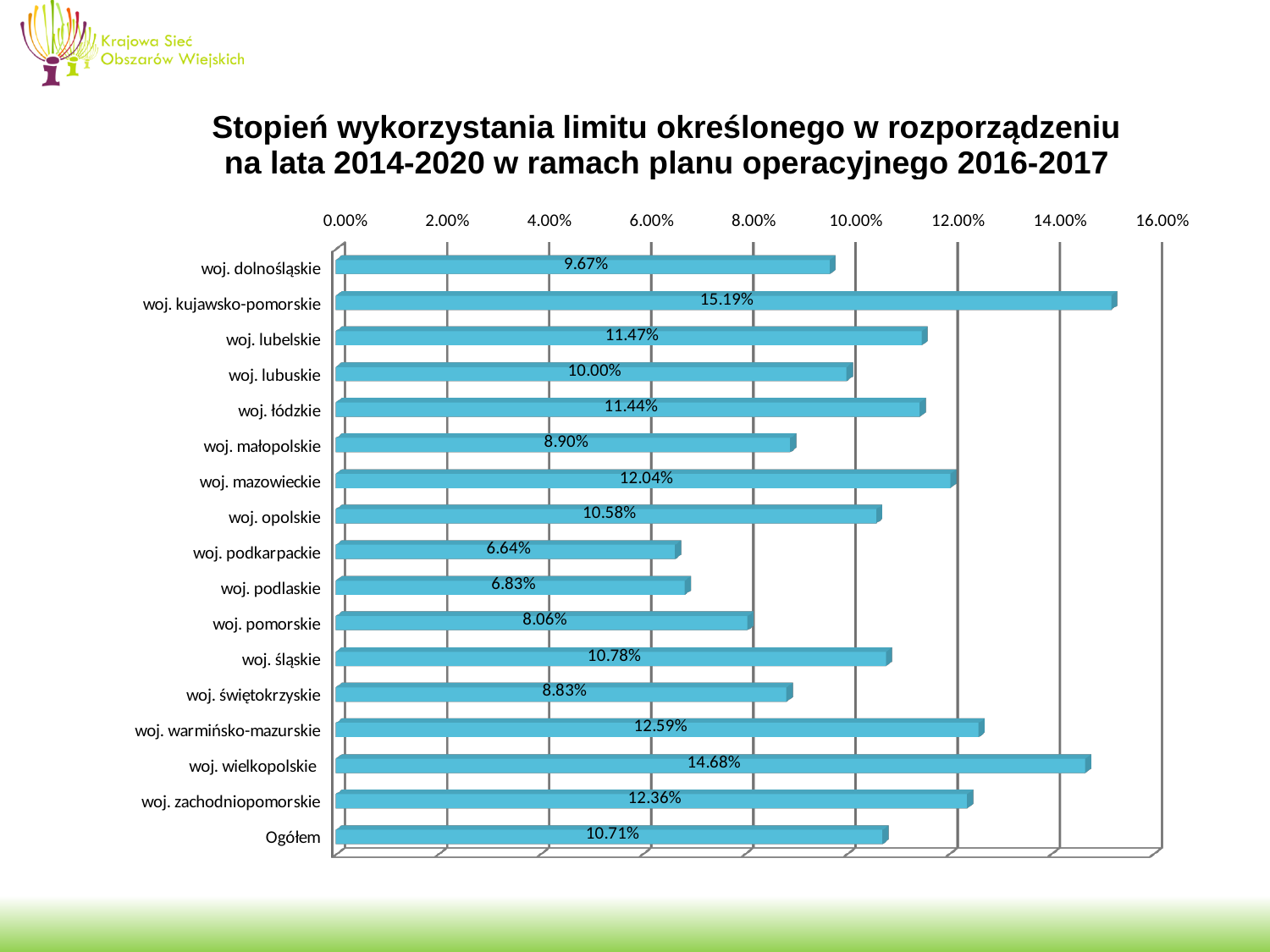
What is the maximum value shown on the horizontal axis? 16.00% What is the value for woj. podkarpackie? 6.64% What kind of chart is shown on the slide? bar chart Is the value for woj. warmińsko-mazurskie greater or less than 12.00%? greater Which category has the highest value? woj. kujawsko-pomorskie What is the value for Ogółem? 10.71% Which is larger, the value for woj. mazowieckie or woj. opolskie? woj. mazowieckie What is the difference between the values for woj. wielkopolskie and woj. dolnośląskie? 5.01% Which category has the lowest value? woj. podkarpackie What is the difference between the values for woj. lubelskie and woj. łódzkie? 0.03% What is the value for woj. kujawsko-pomorskie? 15.19% How many categories are shown on the chart? 17